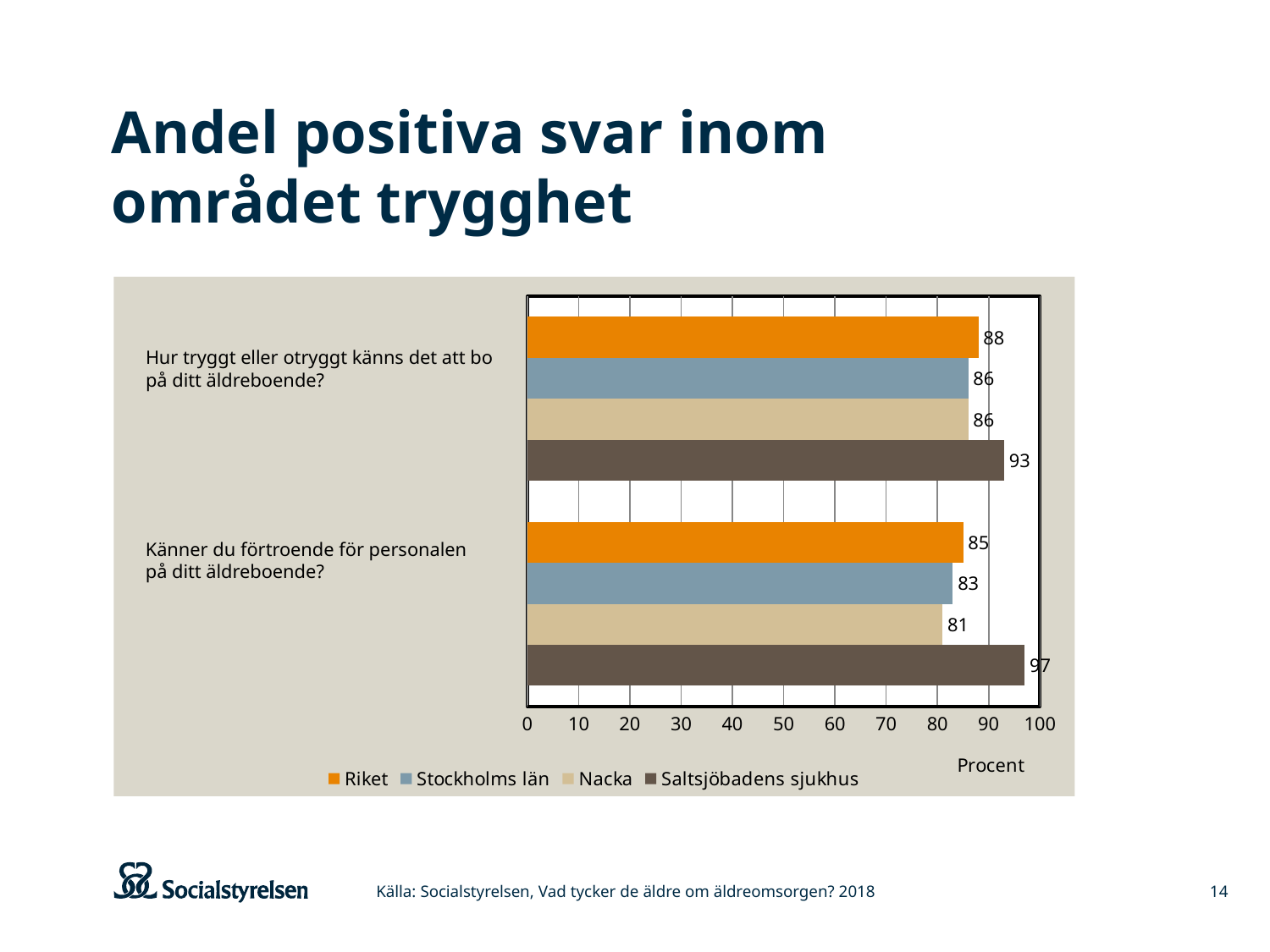
What unit is shown on the horizontal axis of the chart? Procent What is the value for Saltsjöbadens sjukhus on the question "Hur tryggt eller otryggt känns det att bo på ditt äldreboende?"? 93 How many survey questions (categories) are shown in the chart? 2 Which is larger on the question "Hur tryggt eller otryggt känns det att bo på ditt äldreboende?": Riket or Stockholms län? Riket What is the value for Nacka on the question "Känner du förtroende för personalen på ditt äldreboende?"? 81 What is the difference between Saltsjöbadens sjukhus and Riket on the question "Känner du förtroende för personalen på ditt äldreboende?"? 12 Which series has the highest value on the question "Känner du förtroende för personalen på ditt äldreboende?"? Saltsjöbadens sjukhus How many series does the legend list? 4 What kind of chart is shown on the slide? Bar chart What is the value for Stockholms län on the question "Känner du förtroende för personalen på ditt äldreboende?"? 83 What is the value for Riket on the question "Hur tryggt eller otryggt känns det att bo på ditt äldreboende?"? 88 Which series has the lowest value on the question "Känner du förtroende för personalen på ditt äldreboende?"? Nacka